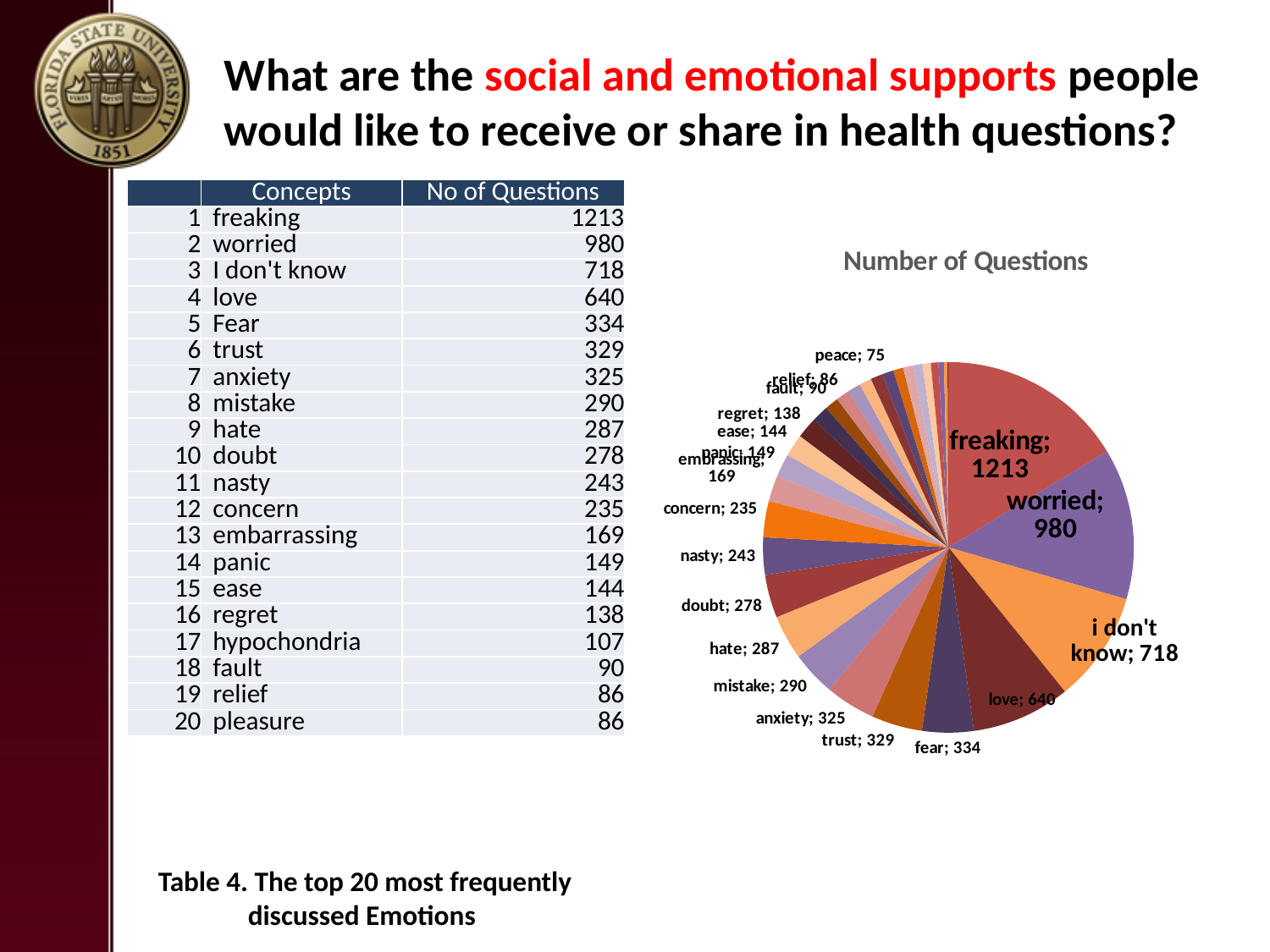
What type of chart is shown on the slide? pie chart What is the title of the chart? Number of Questions In the pie chart, what is the difference between the values for freaking and worried? 233 In the pie chart, which is larger, the value for worried or the value for i don't know? worried In the pie chart, what is the value for doubt? 278 Which category has the largest slice in the pie chart? freaking In the pie chart, what is the difference between the values for i don't know and love? 78 In the pie chart, what is the value for worried? 980 In the pie chart, what is the value for i don't know? 718 In the pie chart, which is larger, the value for hate or the value for nasty? hate In the pie chart, what is the value for freaking? 1213 In the pie chart, what is the value for peace? 75